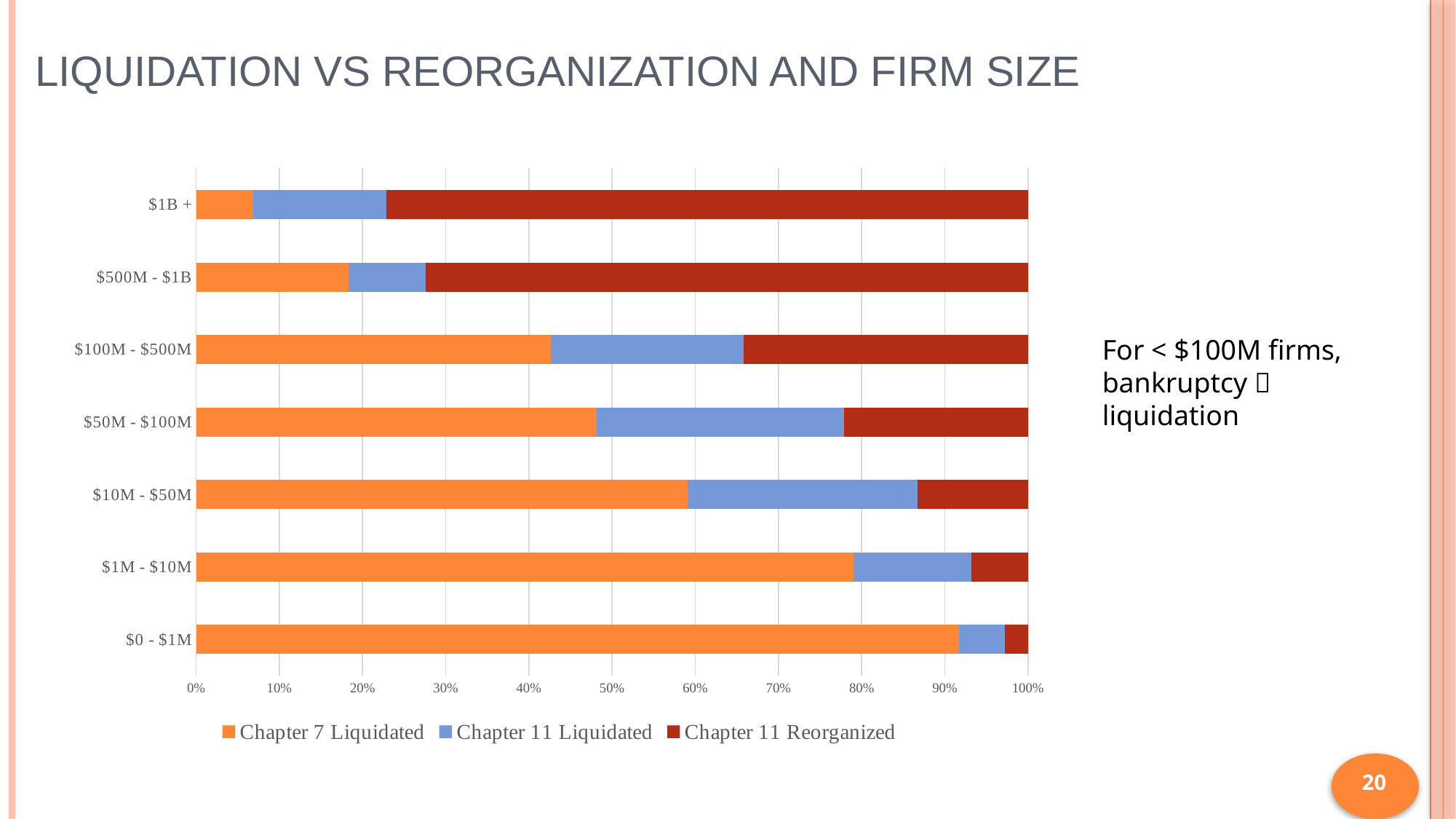
Which series is shown in dark red in the chart? Chapter 11 Reorganized As firm size increases, does the Chapter 7 Liquidated share rise or fall? fall Which firm size category has the largest Chapter 7 Liquidated share? $0 - $1M How many firm size categories are shown on the chart? 7 Is the Chapter 7 Liquidated share for $100M - $500M firms greater or less than 50%? less Which has the larger Chapter 7 Liquidated share: $1M - $10M firms or $10M - $50M firms? $1M - $10M Which firm size category has the smallest Chapter 11 Reorganized share? $0 - $1M Which firm size category has the smallest Chapter 7 Liquidated share? $1B + Is the Chapter 7 Liquidated share for $1B + firms greater or less than 10%? less What kind of chart is shown on the slide? Stacked bar chart How many series does the chart legend list? 3 Is the Chapter 7 Liquidated share for $0 - $1M firms greater or less than 80%? greater